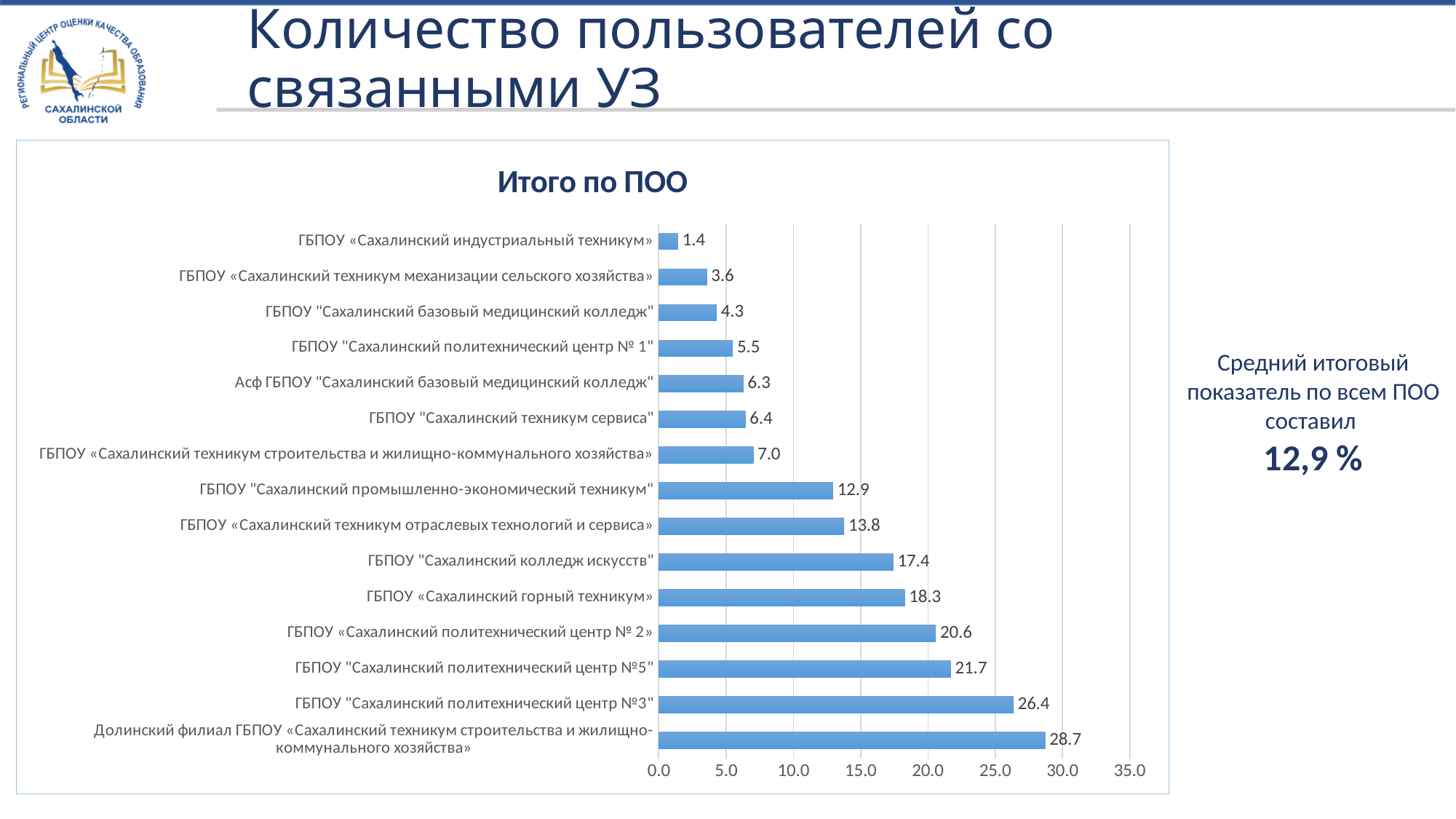
What is the value for ГБПОУ «Сахалинский горный техникум»? 18.3 What type of chart is shown on the slide? bar chart Which category has the lowest value? ГБПОУ «Сахалинский индустриальный техникум» Is the value for ГБПОУ «Сахалинский политехнический центр № 2» greater or less than 20.0? greater Which is larger: the value for ГБПОУ «Сахалинский техникум отраслевых технологий и сервиса» or for ГБПОУ "Сахалинский промышленно-экономический техникум"? ГБПОУ «Сахалинский техникум отраслевых технологий и сервиса» Which category has the highest value? Долинский филиал ГБПОУ «Сахалинский техникум строительства и жилищно-коммунального хозяйства» What is the average overall indicator across all ПОО stated on the slide? 12,9 % How many categories (institutions) are plotted in the chart? 15 What is the value for ГБПОУ "Сахалинский политехнический центр № 1"? 5.5 What is the value for ГБПОУ "Сахалинский колледж искусств"? 17.4 What is the difference between the values for ГБПОУ "Сахалинский политехнический центр №3" and ГБПОУ "Сахалинский политехнический центр №5"? 4.7 What is the title of the chart? Итого по ПОО